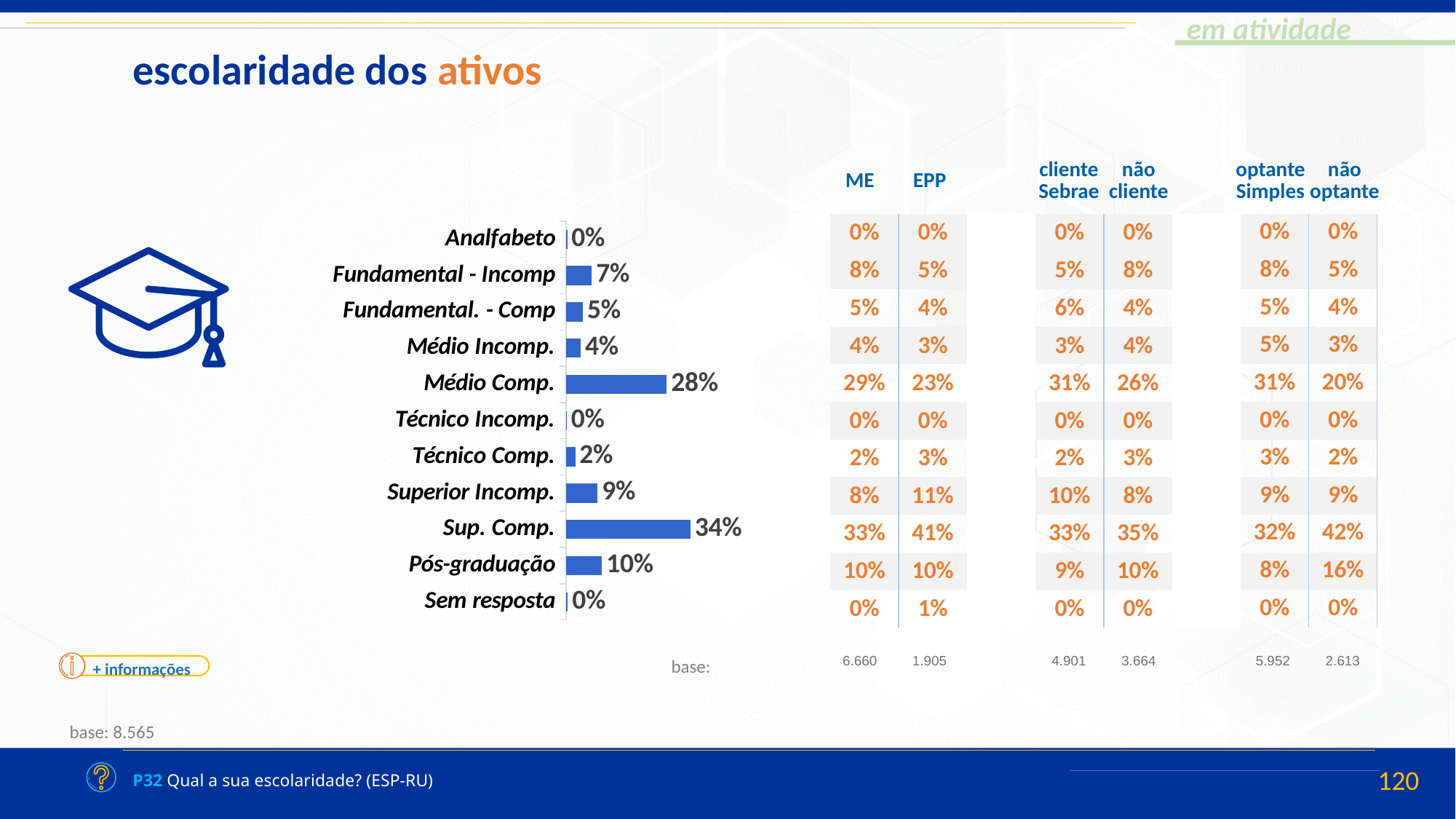
What is the value for Sup. Comp. in the bar chart? 34% Which category has the highest value in the bar chart? Sup. Comp. Which is larger in the bar chart, Superior Incomp. or Fundamental - Incomp? Superior Incomp. How many categories does the bar chart show? 11 What type of chart is shown on the slide? bar chart What is the difference between the values for Sup. Comp. and Médio Comp. in the bar chart? 6% What is the value for Técnico Comp. in the bar chart? 2% What is the value for Médio Comp. in the bar chart? 28% What is the value for Pós-graduação in the bar chart? 10% What is the value for Fundamental - Incomp in the bar chart? 7% What is the title of the slide containing the bar chart? escolaridade dos ativos What is the difference between the values for Pós-graduação and Médio Incomp. in the bar chart? 6%